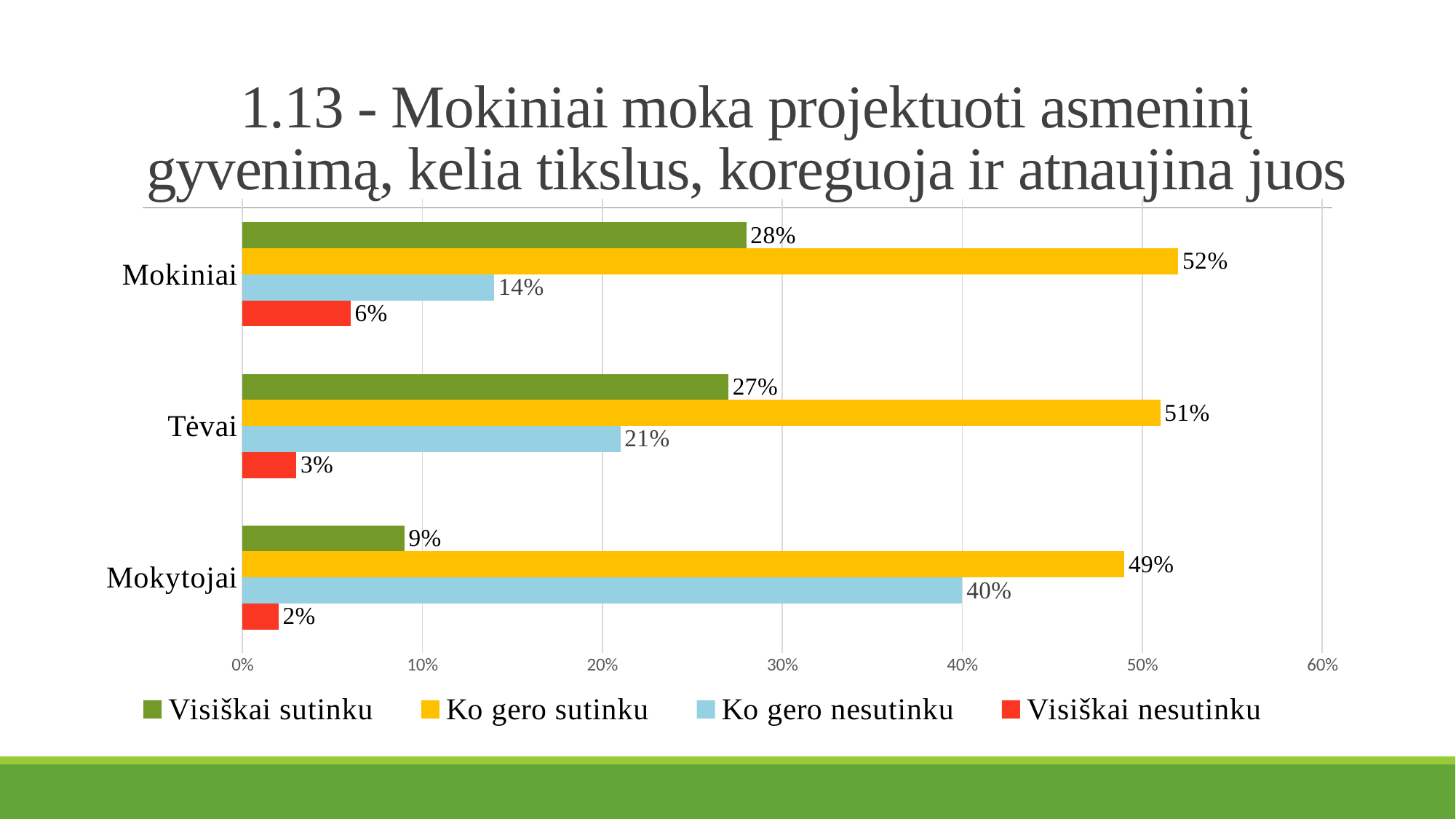
Which is larger: the "Ko gero nesutinku" value for Tėvai or for Mokiniai? Tėvai How many series does the legend list? 4 What is the difference between the "Ko gero sutinku" values for Mokiniai and Mokytojai? 3% Which category has the lowest value for "Visiškai sutinku"? Mokytojai How many categories are shown on the y axis? 3 What is the value for "Visiškai nesutinku" for Tėvai? 3% What is the value for "Ko gero sutinku" for Mokiniai? 52% Which category has the highest value for "Ko gero nesutinku"? Mokytojai Is the "Ko gero sutinku" value for Tėvai greater or less than 50%? greater Which colour represents "Visiškai nesutinku" in the legend? red What is the value for "Ko gero nesutinku" for Mokytojai? 40% What kind of chart is shown on the slide? bar chart